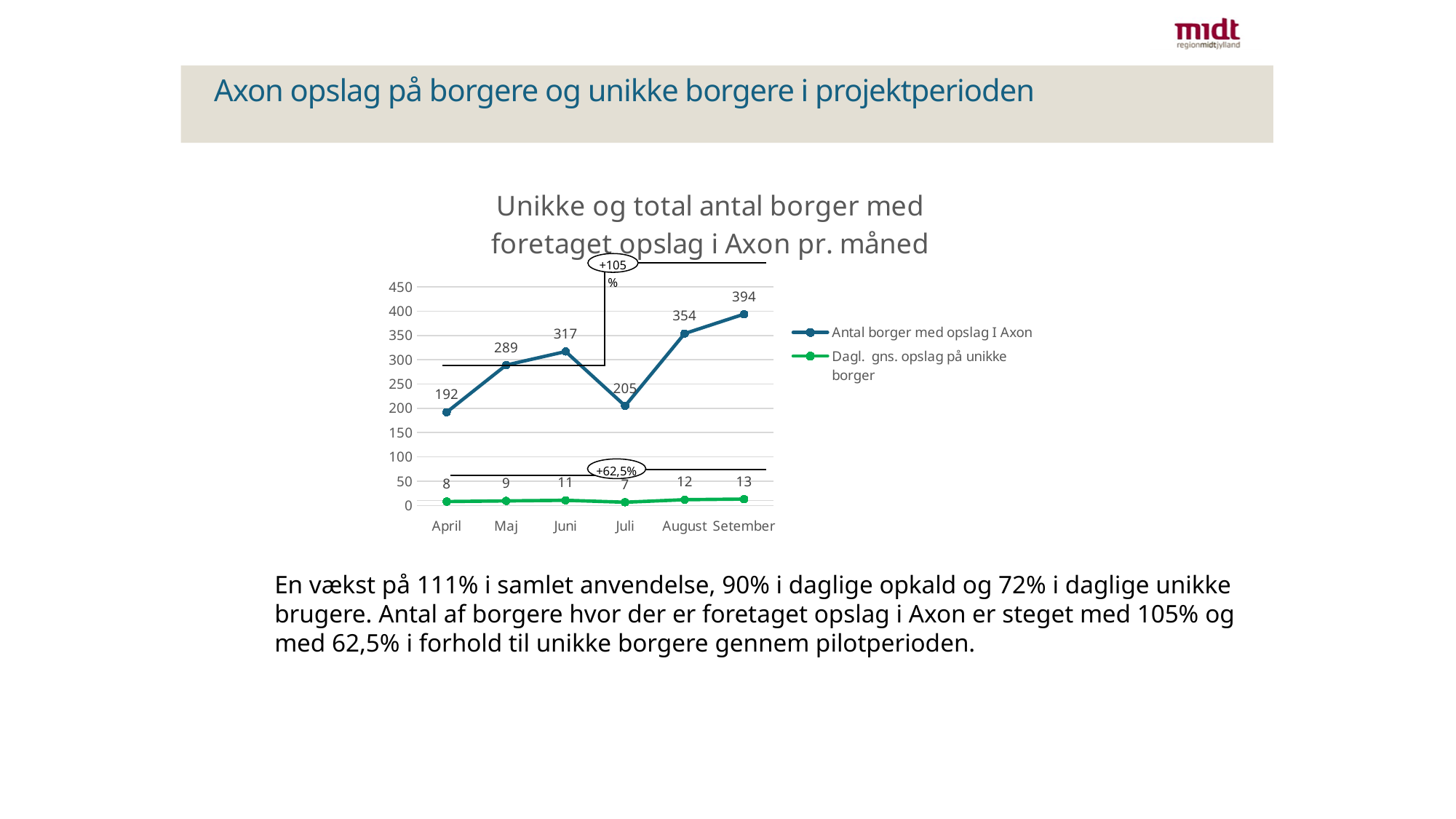
What is the difference between Antal borger med opslag I Axon in August and in Juli? 149 What is the value for Dagl. gns. opslag på unikke borger in Juli? 7 What is the value for Antal borger med opslag I Axon in Setember? 394 What is the title of the chart? Unikke og total antal borger med foretaget opslag i Axon pr. måned In which month is Antal borger med opslag I Axon highest? Setember What is the value for Antal borger med opslag I Axon in April? 192 How many series does the legend list? 2 What kind of chart is shown? Line chart Is the value for Antal borger med opslag I Axon in Juni greater or less than 300? greater How many months are shown on the x axis? 6 Which is larger for Antal borger med opslag I Axon: Maj or Juni? Juni In which month is Antal borger med opslag I Axon lowest? April